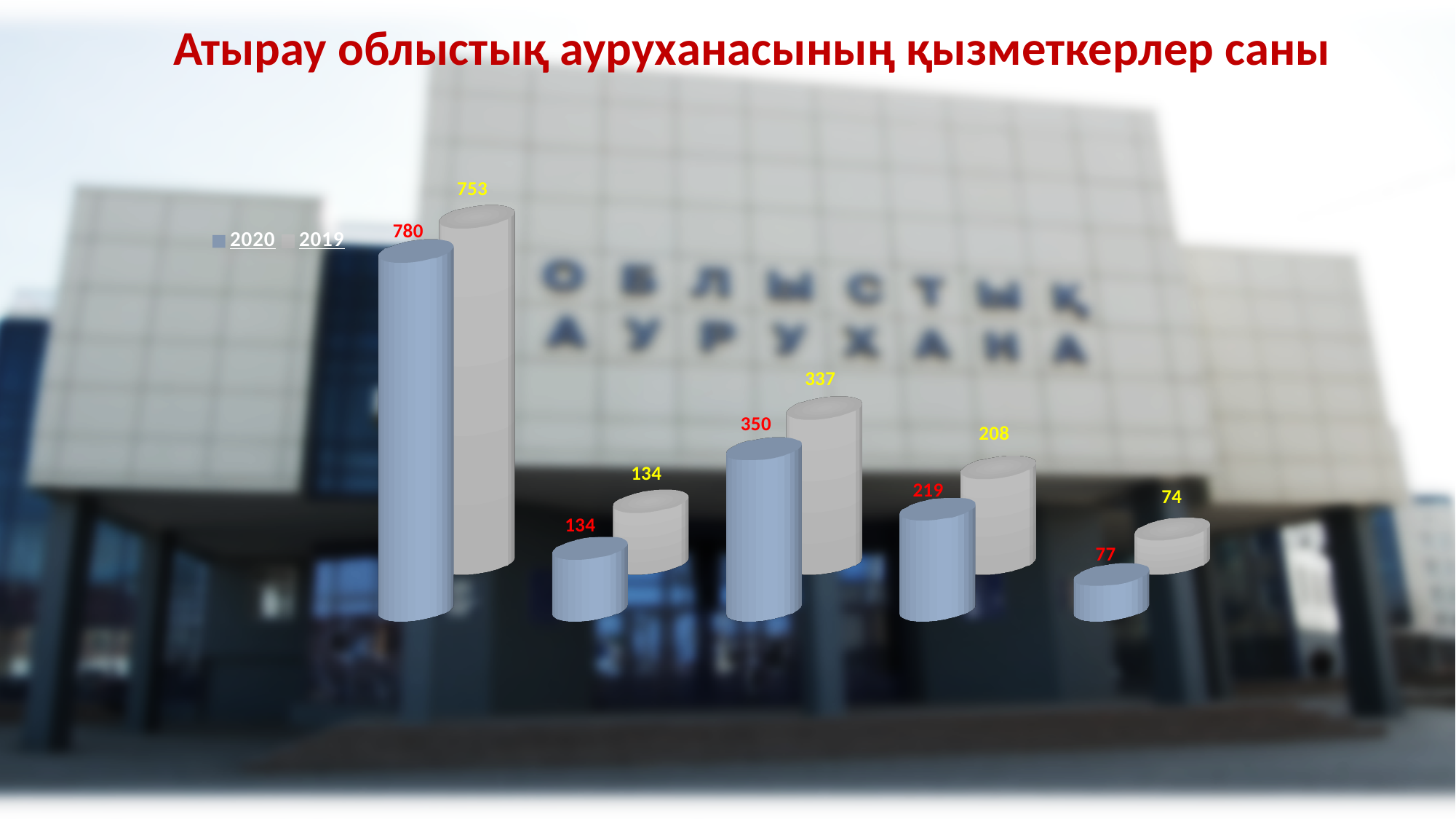
What is the 2020 value for the first (leftmost) group of bars? 780 What is the 2019 value for the first (leftmost) group of bars? 753 Which group of bars has the highest 2020 value? the first (leftmost) group, 780 How many groups of bars are plotted in the chart? 5 What is the 2019 value for the third group of bars from the left? 337 In the fourth group of bars from the left, which is larger: the 2020 value or the 2019 value? 2020 (219) How many series does the chart legend list? 2 What is the difference between the 2020 and 2019 values in the first (leftmost) group of bars? 27 What is the 2020 value for the rightmost group of bars? 77 What is the title of the chart on the slide? Атырау облыстық ауруханасының қызметкерлер саны Which two series are listed in the chart legend? 2020 and 2019 What kind of chart is shown on the slide? bar chart